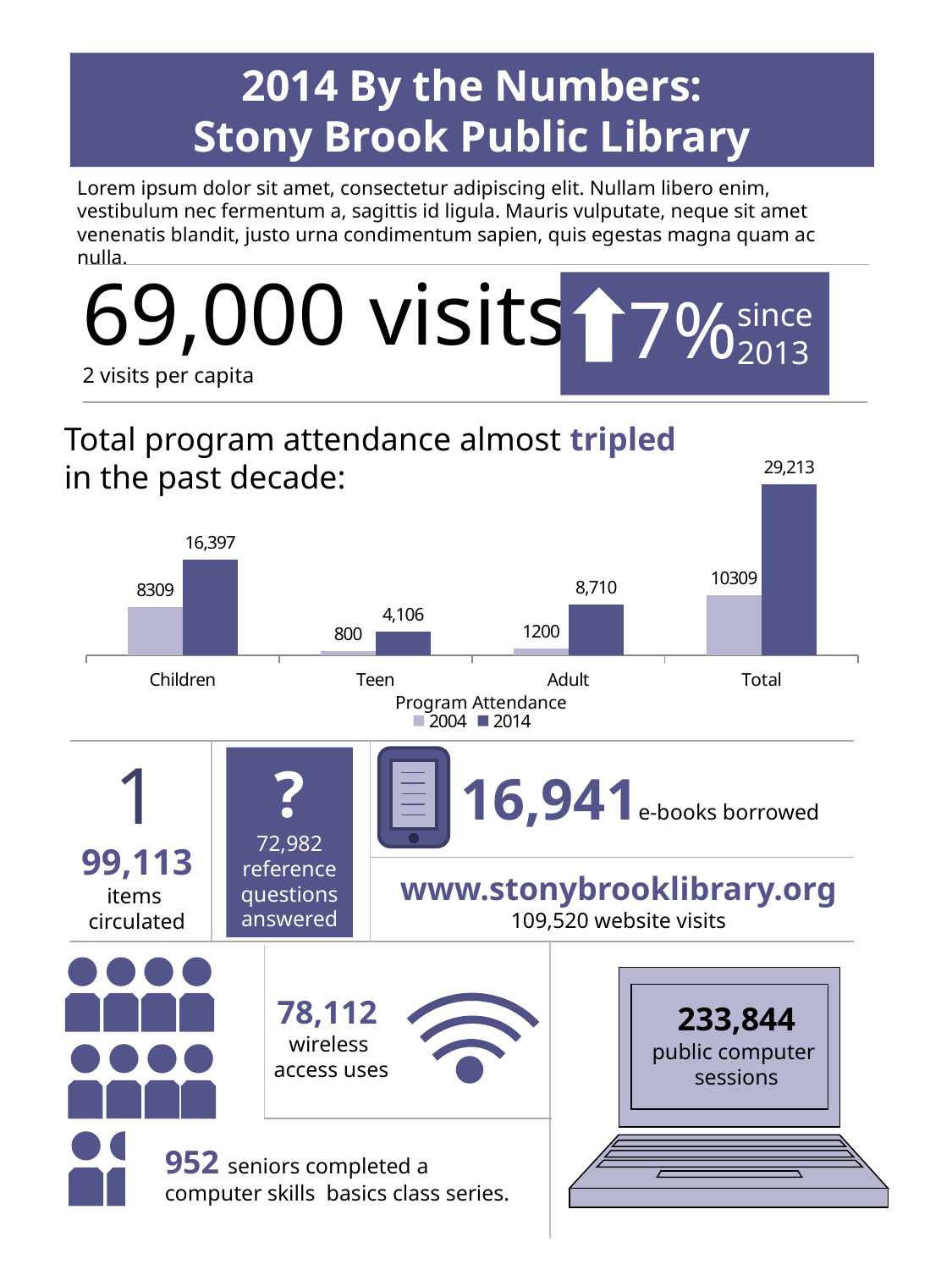
How many series does the legend of the Program Attendance chart list? 2 Which category had the lowest 2004 program attendance? Teen How many categories are shown on the x axis of the Program Attendance chart? 4 By how much did Children program attendance increase from 2004 to 2014? 8,088 What was the 2014 program attendance for Adult? 8,710 What was the 2004 program attendance for Total? 10309 What type of chart is used to show Program Attendance? Bar chart Which is larger: the 2014 Adult attendance or the 2004 Children attendance? 2014 Adult attendance What was the 2004 program attendance for Teen? 800 What was the 2014 program attendance for Children? 16,397 Excluding the Total category, which category had the highest 2014 program attendance? Children What is the difference between the 2014 and 2004 Total program attendance? 18,904